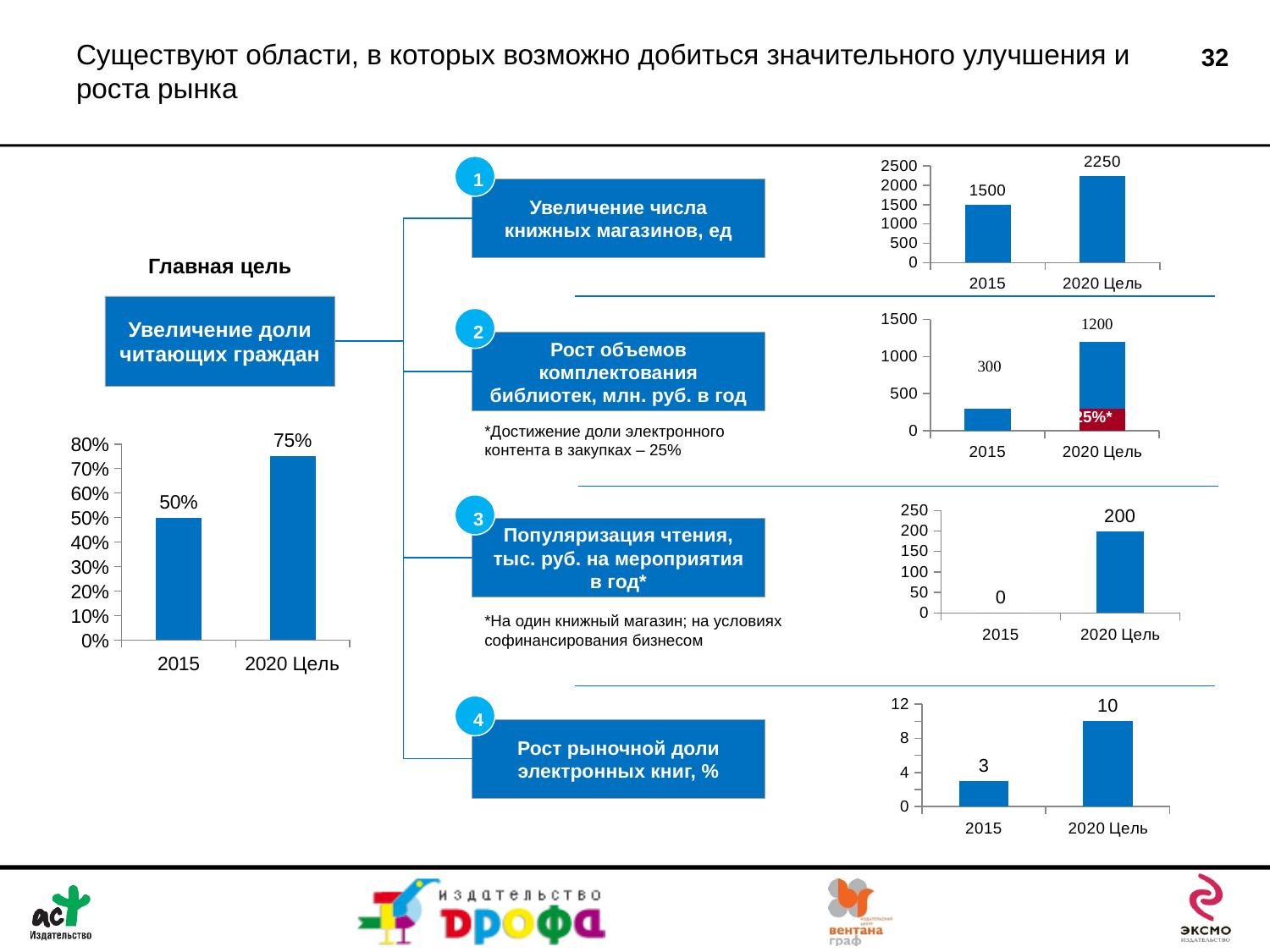
In the chart next to 'Рост объемов комплектования библиотек, млн. руб. в год', which category has the higher value, 2015 or 2020 Цель? 2020 Цель In the top-right chart next to 'Увеличение числа книжных магазинов, ед', what is the value for 2020 Цель? 2250 In the chart next to 'Популяризация чтения, тыс. руб. на мероприятия в год*', what is the value for 2020 Цель? 200 In the chart next to 'Рост объемов комплектования библиотек, млн. руб. в год', what is the value for 2015? 300 In the chart on the left under 'Главная цель', what is the difference between the 2020 Цель value and the 2015 value? 25% In the bottom-right chart next to 'Рост рыночной доли электронных книг, %', what is the value for 2015? 3 In the chart on the left under 'Главная цель', what is the value for 2020 Цель? 75% In the chart on the left under 'Главная цель', what is the value for 2015? 50% In the chart next to 'Популяризация чтения, тыс. руб. на мероприятия в год*', what is the value for 2015? 0 What type of chart is used for the chart on the left under 'Главная цель'? Bar chart In the top-right chart next to 'Увеличение числа книжных магазинов, ед', what is the difference between 2020 Цель and 2015? 750 In the bottom-right chart next to 'Рост рыночной доли электронных книг, %', what is the difference between 2020 Цель and 2015? 7